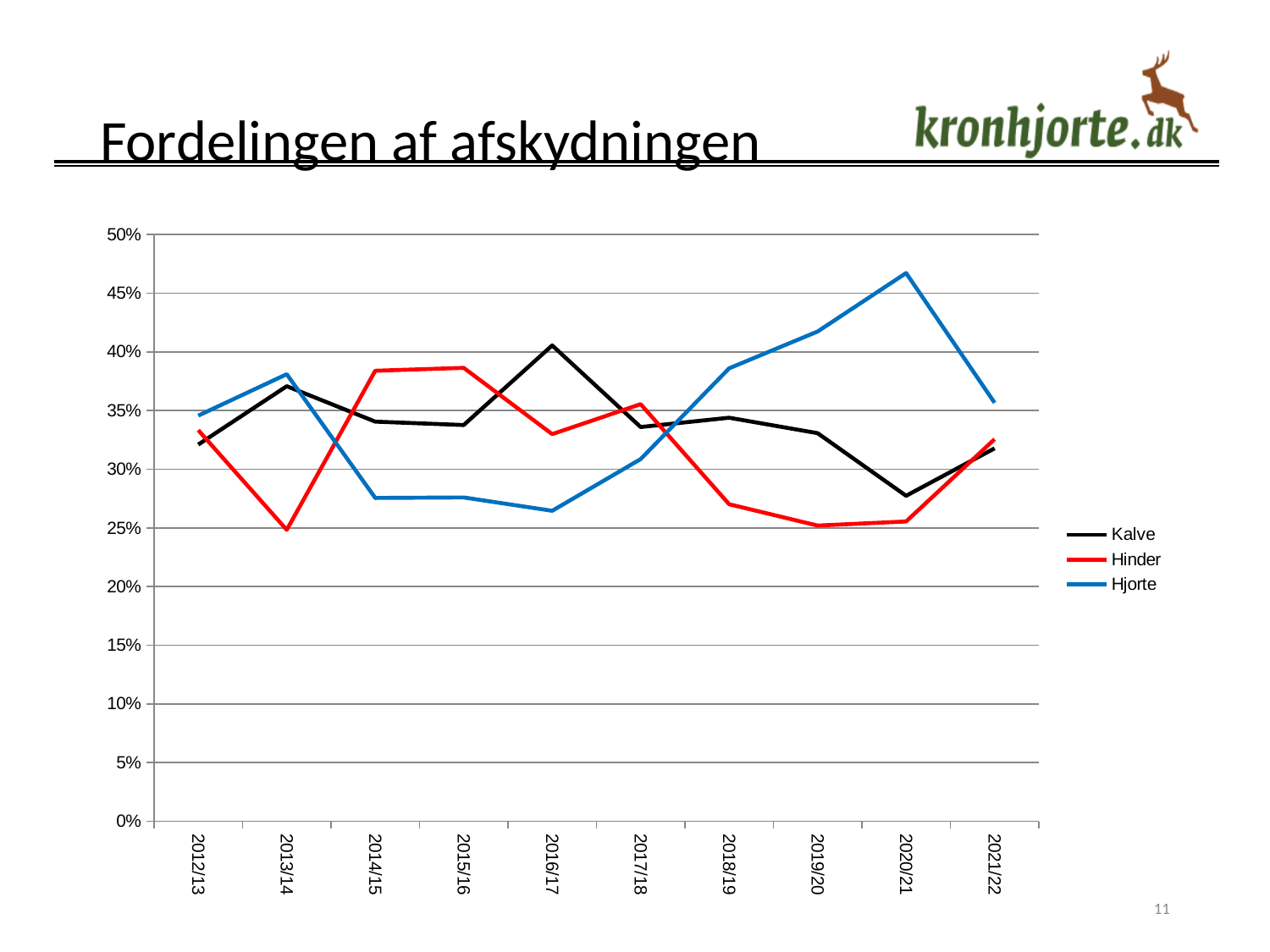
In which season does the Hjorte series reach its lowest value? 2016/17 How many seasons are plotted along the x axis? 10 In which season does the Hjorte series reach its highest value? 2020/21 In 2014/15, which series has the larger value, Hinder or Hjorte? Hinder Is the value for Hjorte in 2020/21 greater or less than 45%? greater In which season does the Kalve series reach its highest value? 2016/17 Does the Hjorte series rise or fall from 2016/17 to 2020/21? rise Is the value for Kalve in 2020/21 greater or less than 30%? less How many series does the legend list? 3 In 2020/21, which series has the larger value, Hjorte or Kalve? Hjorte What kind of chart is shown on the slide? line chart Is the value for Hinder in 2013/14 greater or less than 30%? less